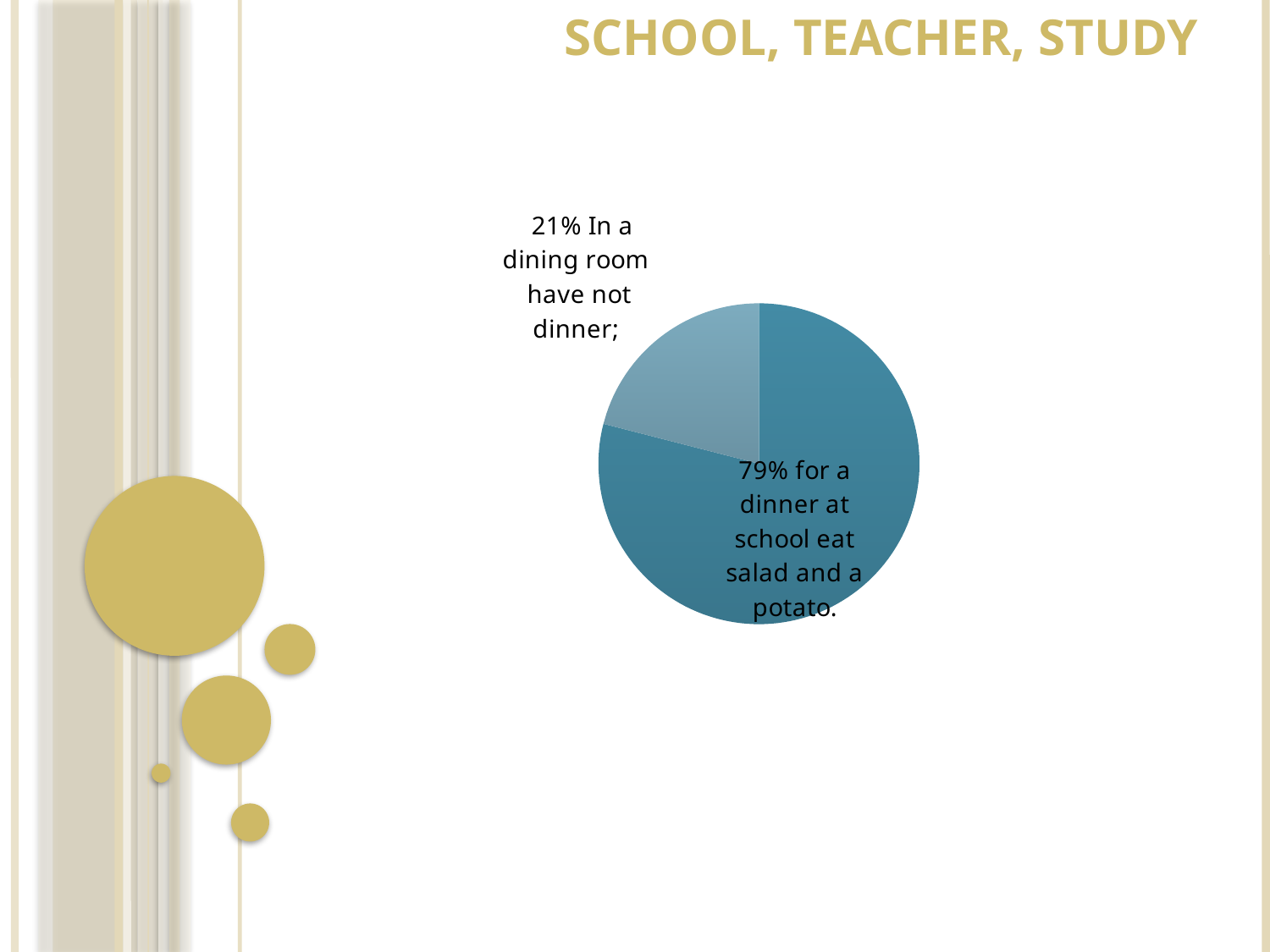
What is the title shown at the top of the slide? SCHOOL, TEACHER, STUDY Which is larger: the share for 'dinner at school eat salad and a potato' or the share for 'In a dining room have not dinner'? dinner at school eat salad and a potato What percentage of the pie is labelled 'In a dining room have not dinner'? 21% What kind of chart is shown on the slide? pie chart Which slice is the largest in the pie chart? 79% for a dinner at school eat salad and a potato Is the share for 'In a dining room have not dinner' greater or less than 50%? less What percentage of the pie is labelled 'for a dinner at school eat salad and a potato'? 79% How many slices does the pie chart have? 2 Which slice is the smallest in the pie chart? 21% In a dining room have not dinner Which slice of the pie is shown in the lighter blue colour? 21% In a dining room have not dinner What is the difference in percentage points between the two slices of the pie chart? 58